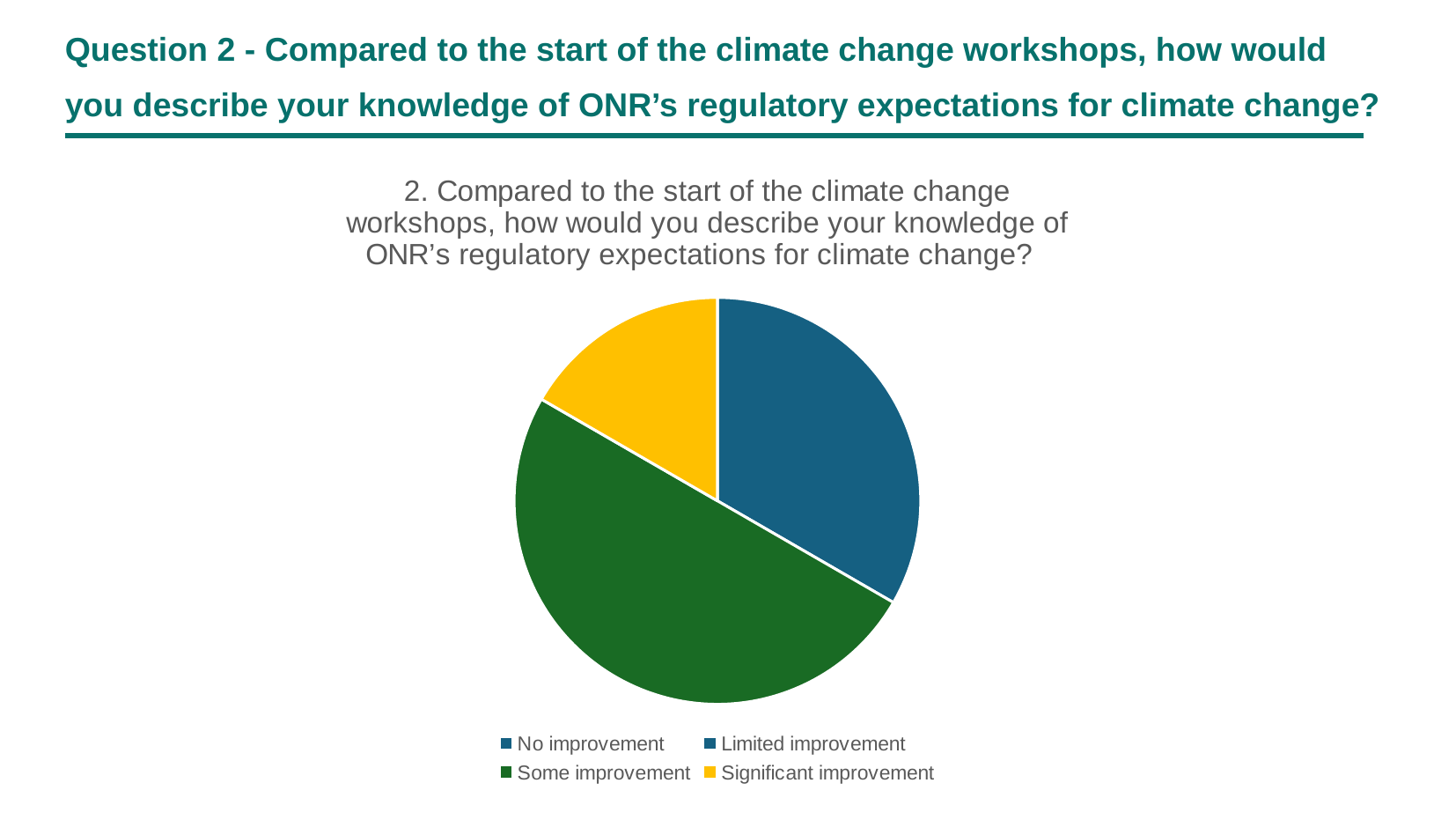
How many categories does the legend of the pie chart list? 4 Which slice is larger, Limited improvement or Significant improvement? Limited improvement Which slice is larger, Some improvement or Limited improvement? Some improvement What colour is the Significant improvement slice in the pie chart? yellow What kind of chart is shown on the slide? pie chart Which category has the largest slice of the pie chart? Some improvement What colour is the Some improvement slice in the pie chart? green Which slice is larger, Significant improvement or Some improvement? Some improvement